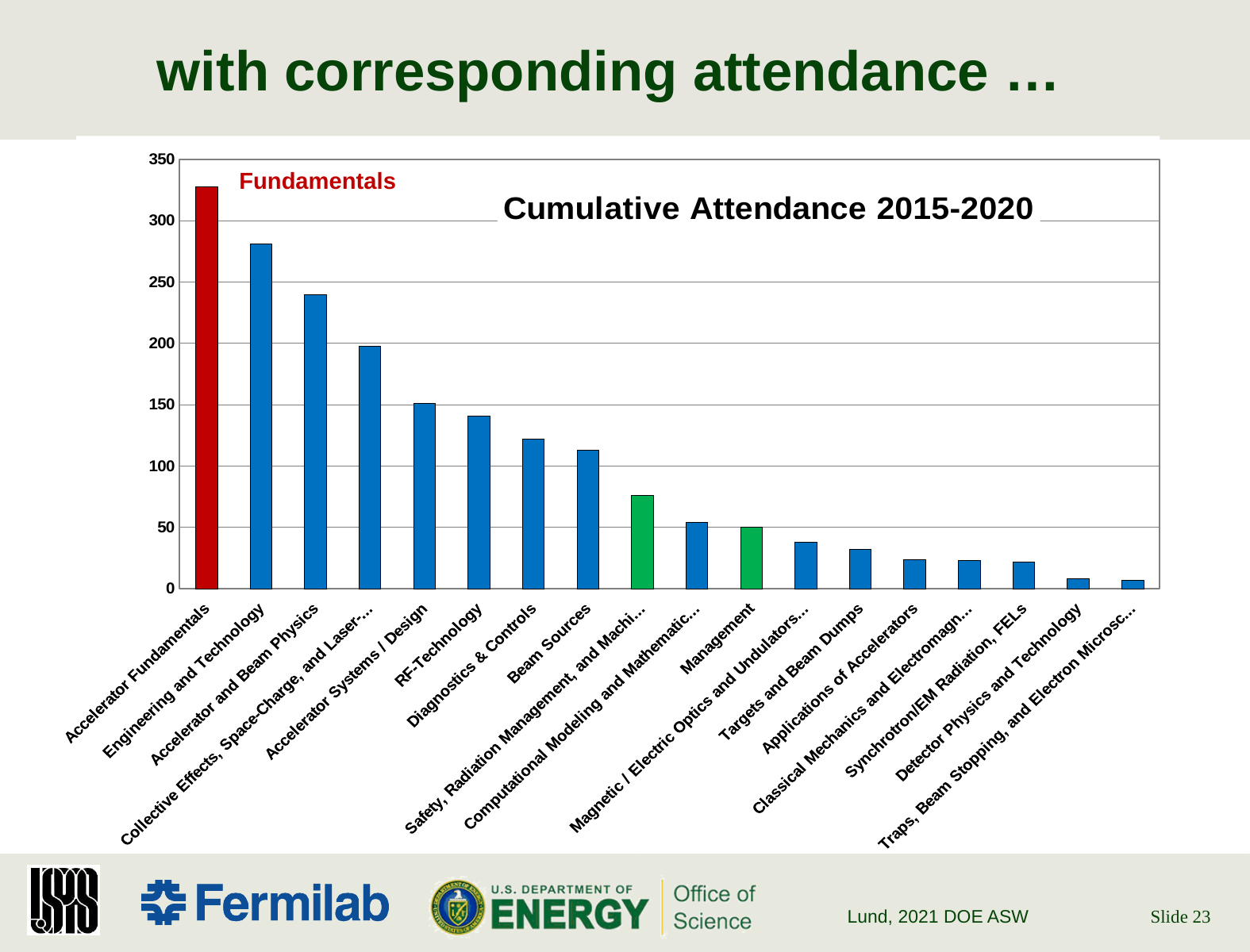
Is the value for Accelerator Fundamentals greater or less than 300? greater Which is larger, the value for Accelerator and Beam Physics or the value for Accelerator Systems / Design? Accelerator and Beam Physics Is the value for RF-Technology greater or less than 150? less Do the bar values rise or fall moving from left to right along the x axis? fall Is the value for Beam Sources greater or less than 100? greater Which is larger, the value for Diagnostics & Controls or the value for Management? Diagnostics & Controls Which category has the highest cumulative attendance? Accelerator Fundamentals What is the title of the chart? Cumulative Attendance 2015-2020 What colour is the bar for Accelerator Fundamentals? red How many categories are plotted on the x axis? 18 What kind of chart is shown on the slide? bar chart